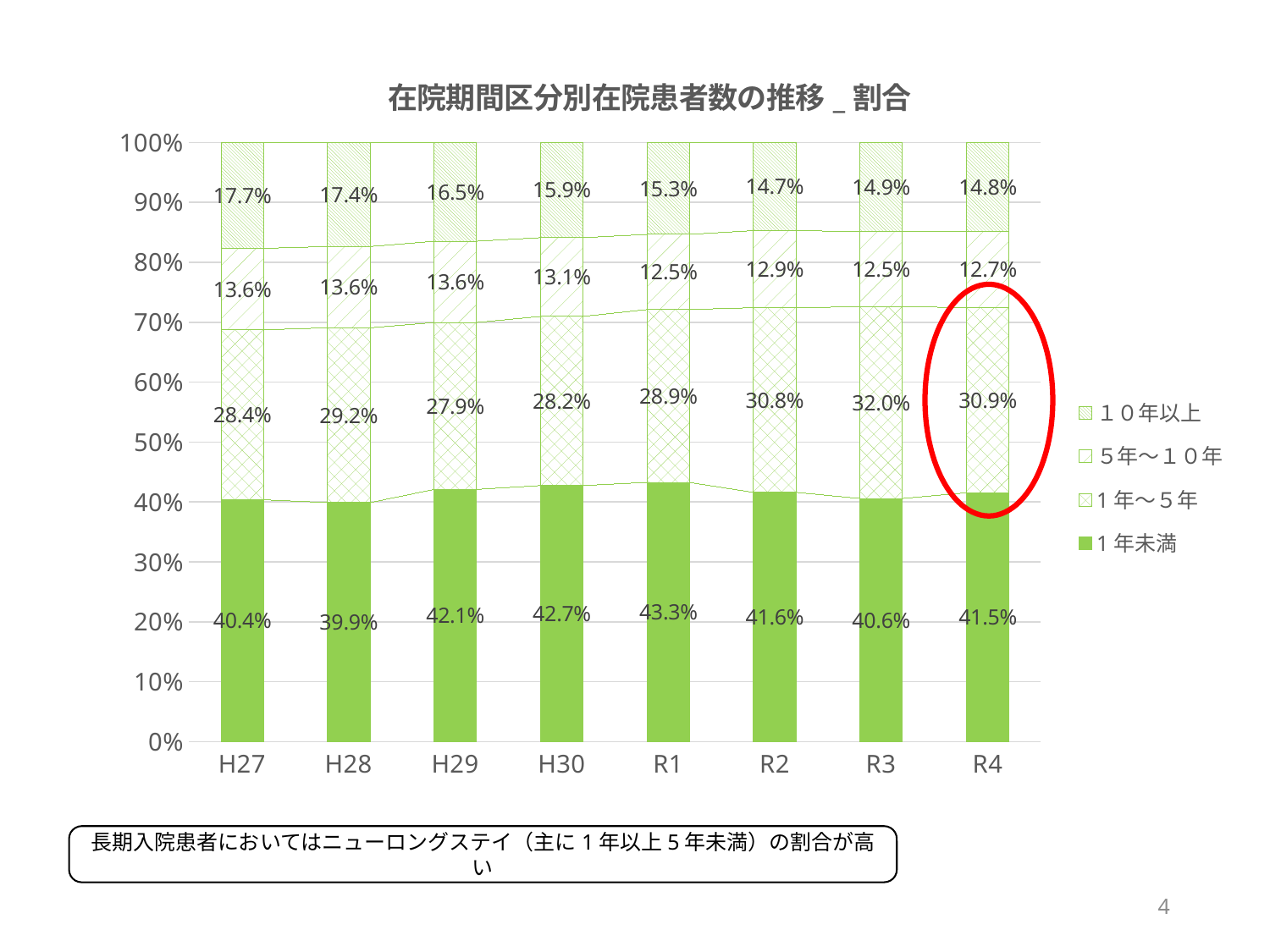
What is the value for 5年～10年 in H30? 13.1% In which year is the 1年未満 share highest? R1 What is the value for 1年未満 in R1? 43.3% What kind of chart is shown on the slide? Stacked bar chart In which year is the 1年未満 share lowest? H28 In which year is the 1年～5年 share highest? R3 Does the 10年以上 share generally rise or fall from H27 to R4? Fall How many categories (years) are shown on the x axis? 8 How many series does the legend list? 4 What is the difference between the 1年未満 share in R1 and in H28? 3.4 percentage points What is the value for 1年～5年 in R4? 30.9% What is the value for 10年以上 in H27? 17.7%